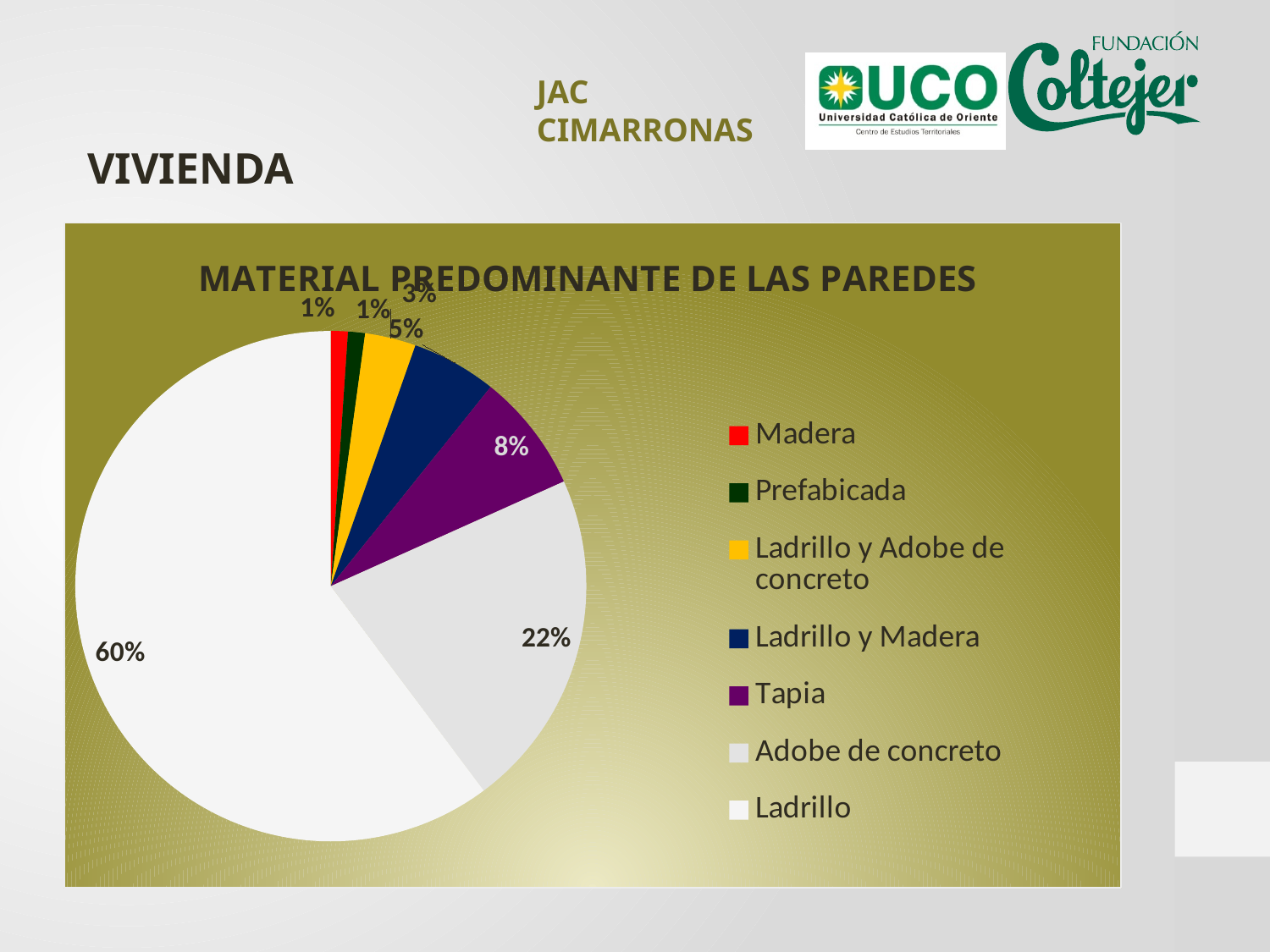
Which category has the largest slice of the pie? Ladrillo What share of the pie does Ladrillo represent? 60% What share of the pie does Adobe de concreto represent? 22% What is the value shown for Ladrillo y Madera? 5% What kind of chart is shown on the slide? pie chart What is the difference between the shares of Ladrillo and Adobe de concreto? 38% What colour is the slice for Tapia? purple How many categories does the legend of the pie chart list? 7 Which is larger, the share for Tapia or the share for Ladrillo y Madera? Tapia What is the value shown for Tapia? 8% What is the value shown for Ladrillo y Adobe de concreto? 3% What is the title of the chart? MATERIAL PREDOMINANTE DE LAS PAREDES